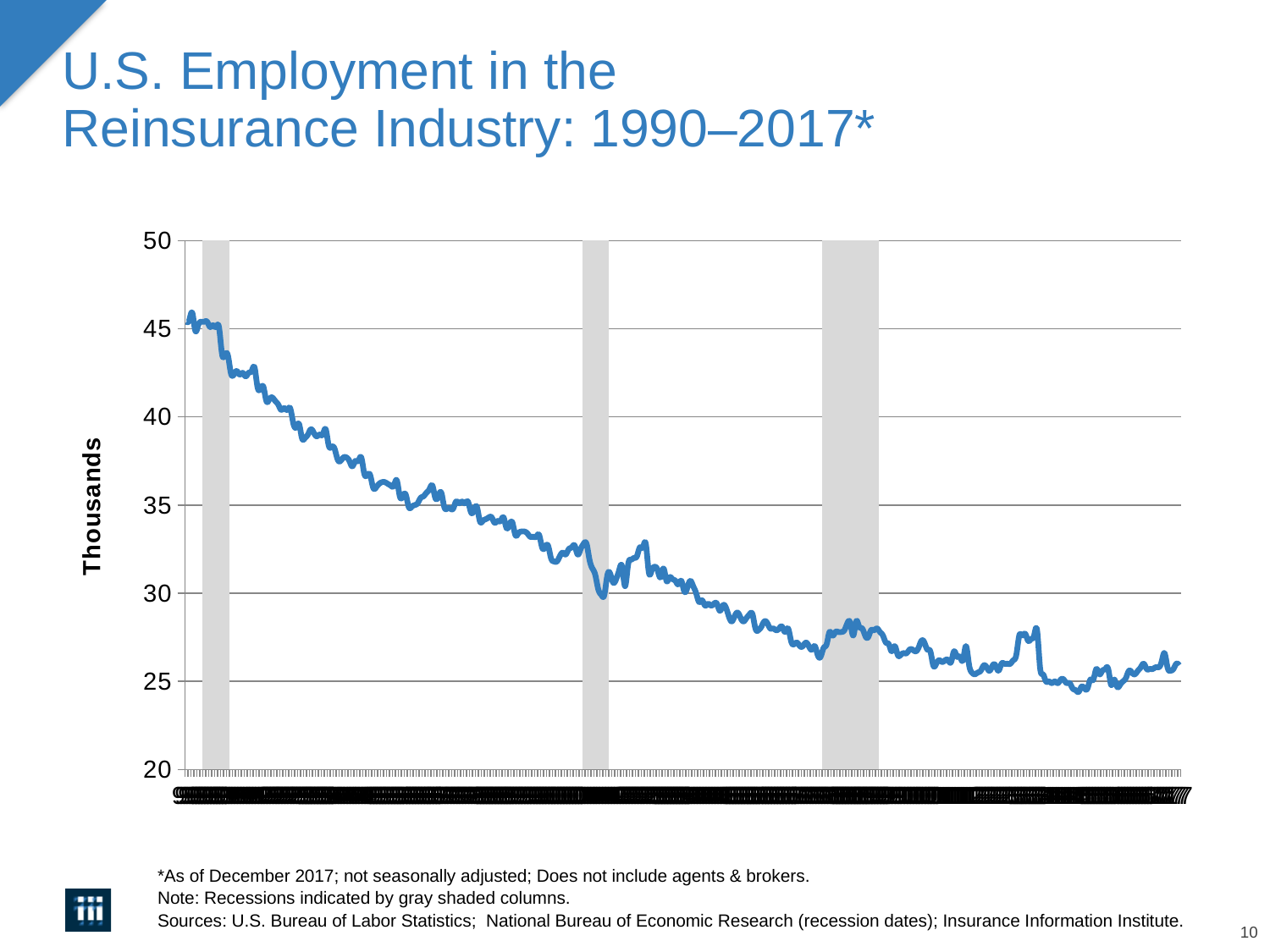
What is the highest value shown on the vertical axis? 50 Is the value at the start of the series greater or less than 50? less How many gray shaded recession columns are shown on the chart? 3 What is the title of the vertical axis? Thousands Is the value at the end of the series (right end of the line) greater or less than 30? less Is the value at the end of the series (right end of the line) greater or less than 25? greater Which is larger, the value at the start of the series or the value at the end of the series? the start of the series Does employment in the reinsurance industry generally rise or fall from the start of the series to the end? fall What kind of chart is shown on the slide? line chart